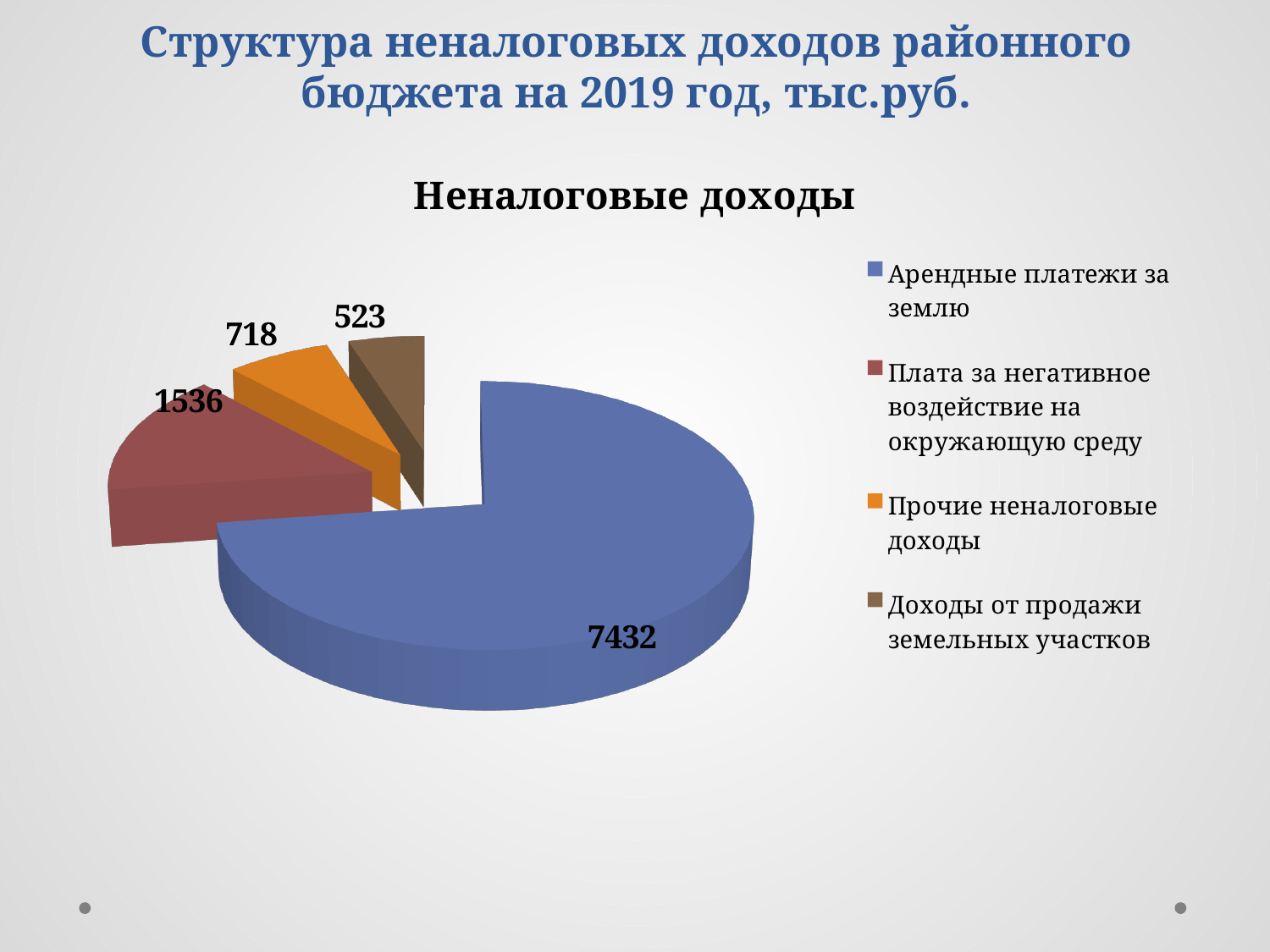
What is the total of all slices in the pie chart? 10209 Which category has the largest slice of the pie? Арендные платежи за землю Which is larger: Прочие неналоговые доходы or Доходы от продажи земельных участков? Прочие неналоговые доходы What is the value for Прочие неналоговые доходы? 718 What is the title of the chart? Неналоговые доходы What is the value for Плата за негативное воздействие на окружающую среду? 1536 What type of chart is shown on the slide? Pie chart What is the difference between the values for Арендные платежи за землю and Плата за негативное воздействие на окружающую среду? 5896 How many slices does the pie chart have? 4 Which category has the smallest slice of the pie? Доходы от продажи земельных участков What is the value for Доходы от продажи земельных участков? 523 What is the value for Арендные платежи за землю? 7432